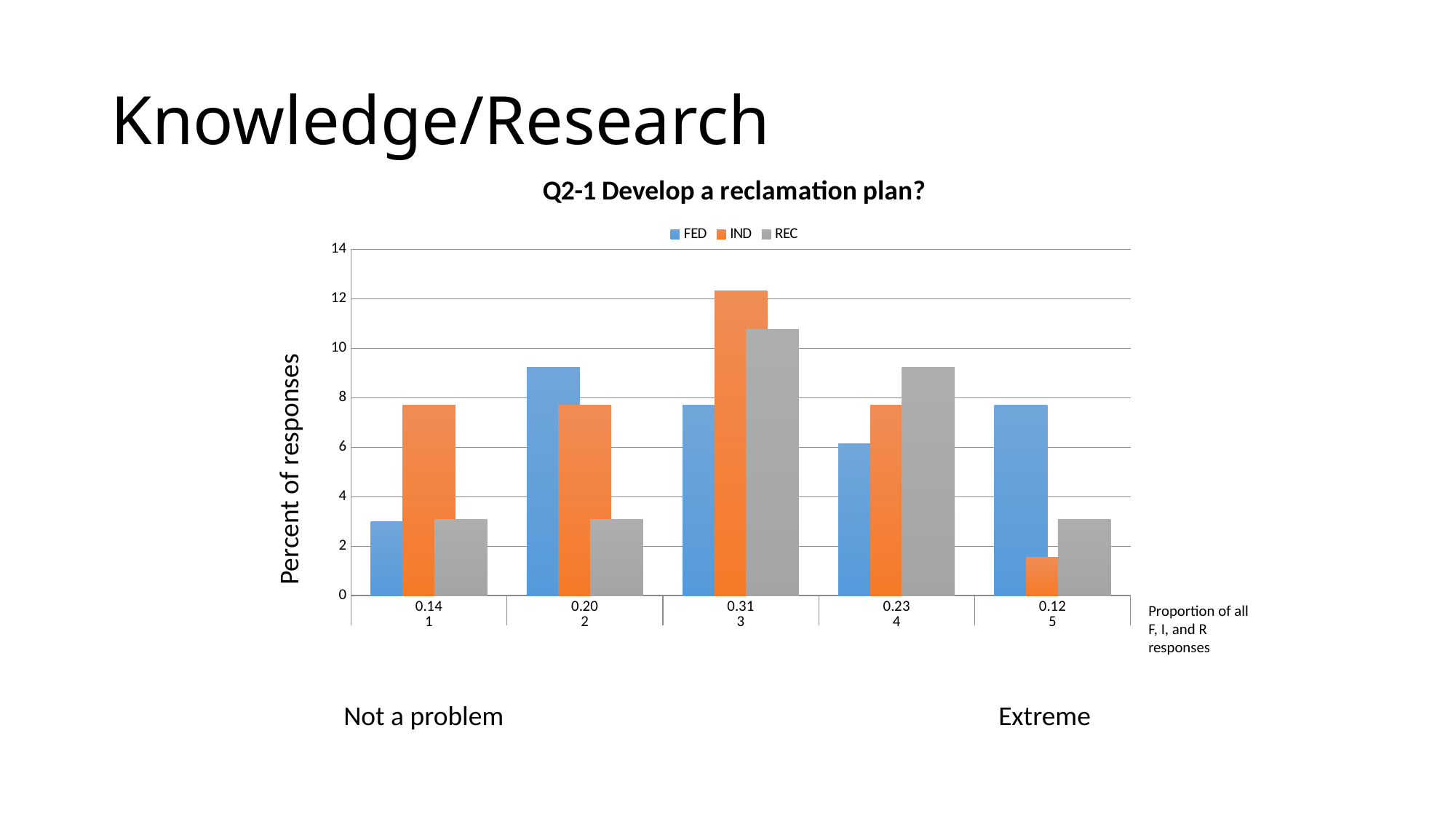
For category 4, which is larger, the REC value or the FED value? REC For which category is the IND bar the highest? 3 Is the FED value for category 1 greater or less than 4? less For which category is the IND bar the lowest? 5 For category 2, which is larger, the FED value or the IND value? FED What are the three series named in the legend? FED, IND, REC How many series does the legend list? 3 How many categories are shown along the x axis? 5 Is the IND value for category 3 greater or less than 10? greater What proportion of all F, I, and R responses is printed under category 3? 0.31 What kind of chart is shown on the slide? bar chart What is the title of the chart? Q2-1 Develop a reclamation plan?